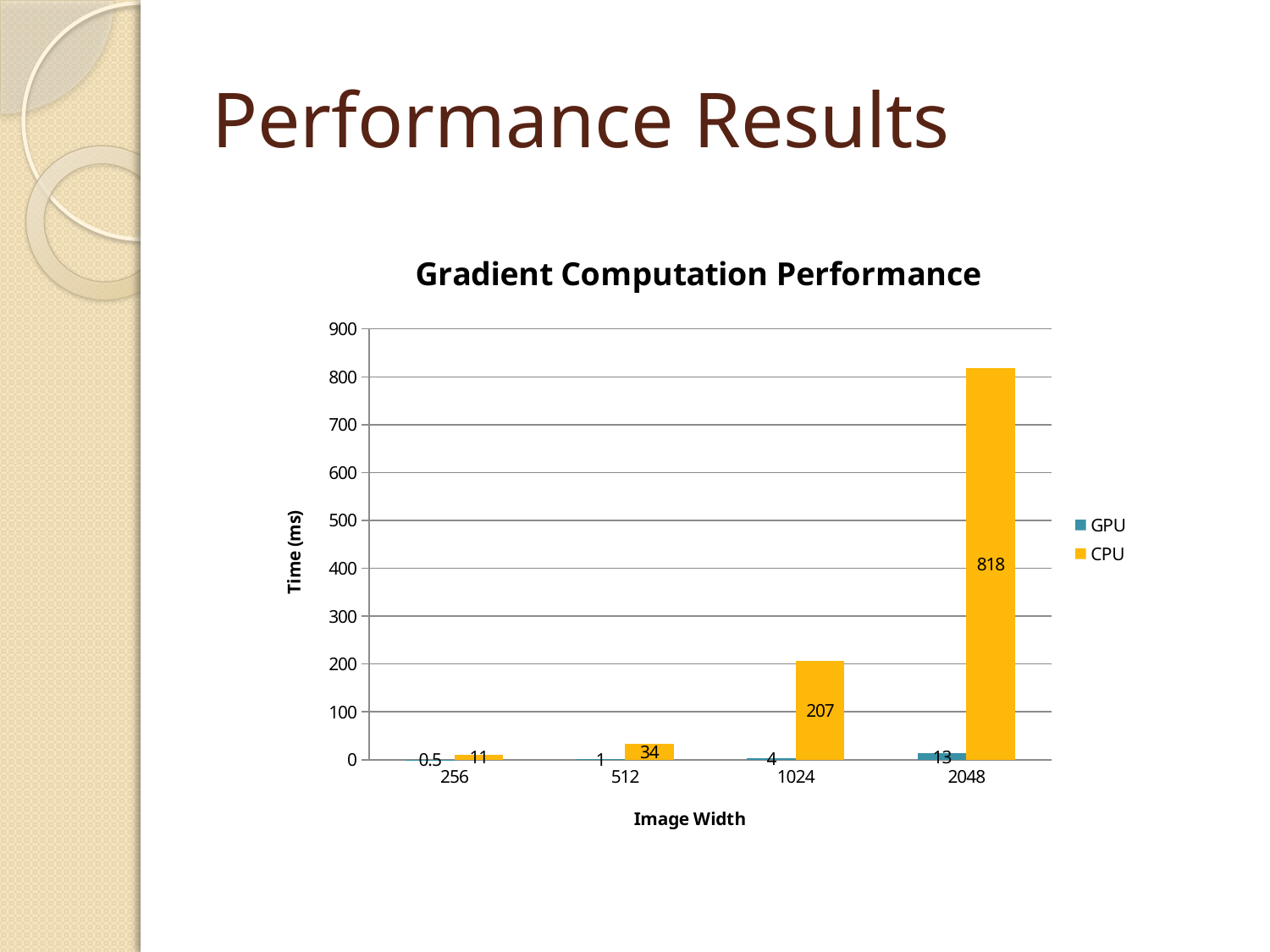
How many series does the legend list? 2 At image width 1024, which is larger, the CPU time or the GPU time? CPU What is the CPU time for image width 512? 34 Which image width has the highest CPU time? 2048 What is the CPU time for image width 2048? 818 What is the GPU time for image width 256? 0.5 Which image width has the lowest GPU time? 256 What kind of chart is shown on the slide? Bar chart Is the CPU time for image width 2048 greater or less than 800? greater What is the GPU time for image width 1024? 4 How many image width categories are shown on the x axis? 4 What is the difference between the CPU and GPU times at image width 2048? 805